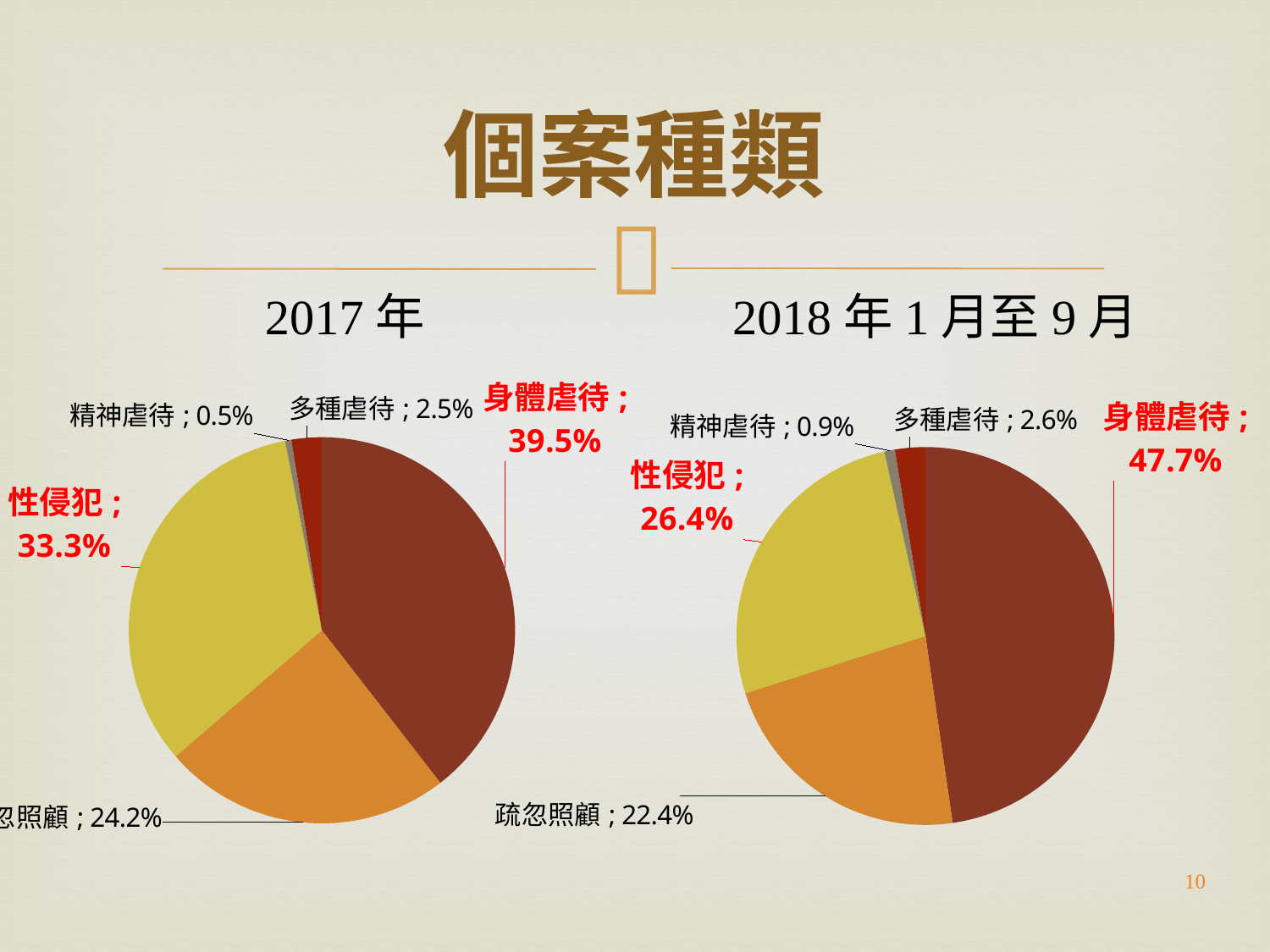
What is the title of the slide? 個案種類 In the 2017 年 chart, what is the share for 身體虐待? 39.5% In the 2018 年 1 月至 9 月 chart, which category has the smallest share? 精神虐待 Which chart shows a larger share for 身體虐待, 2017 年 or 2018 年 1 月至 9 月? 2018 年 1 月至 9 月 In the 2017 年 chart, what is the share for 性侵犯? 33.3% How many categories are shown in the 2018 年 1 月至 9 月 pie chart? 5 In the 2018 年 1 月至 9 月 chart, what is the share for 身體虐待? 47.7% In the 2018 年 1 月至 9 月 chart, what is the share for 疏忽照顧? 22.4% What type of charts are shown on the slide? Pie charts In the 2017 年 chart, which category has the largest share? 身體虐待 In the 2017 年 chart, what is the difference between the shares of 身體虐待 and 性侵犯? 6.2% In the 2018 年 1 月至 9 月 chart, what is the share for 精神虐待? 0.9%